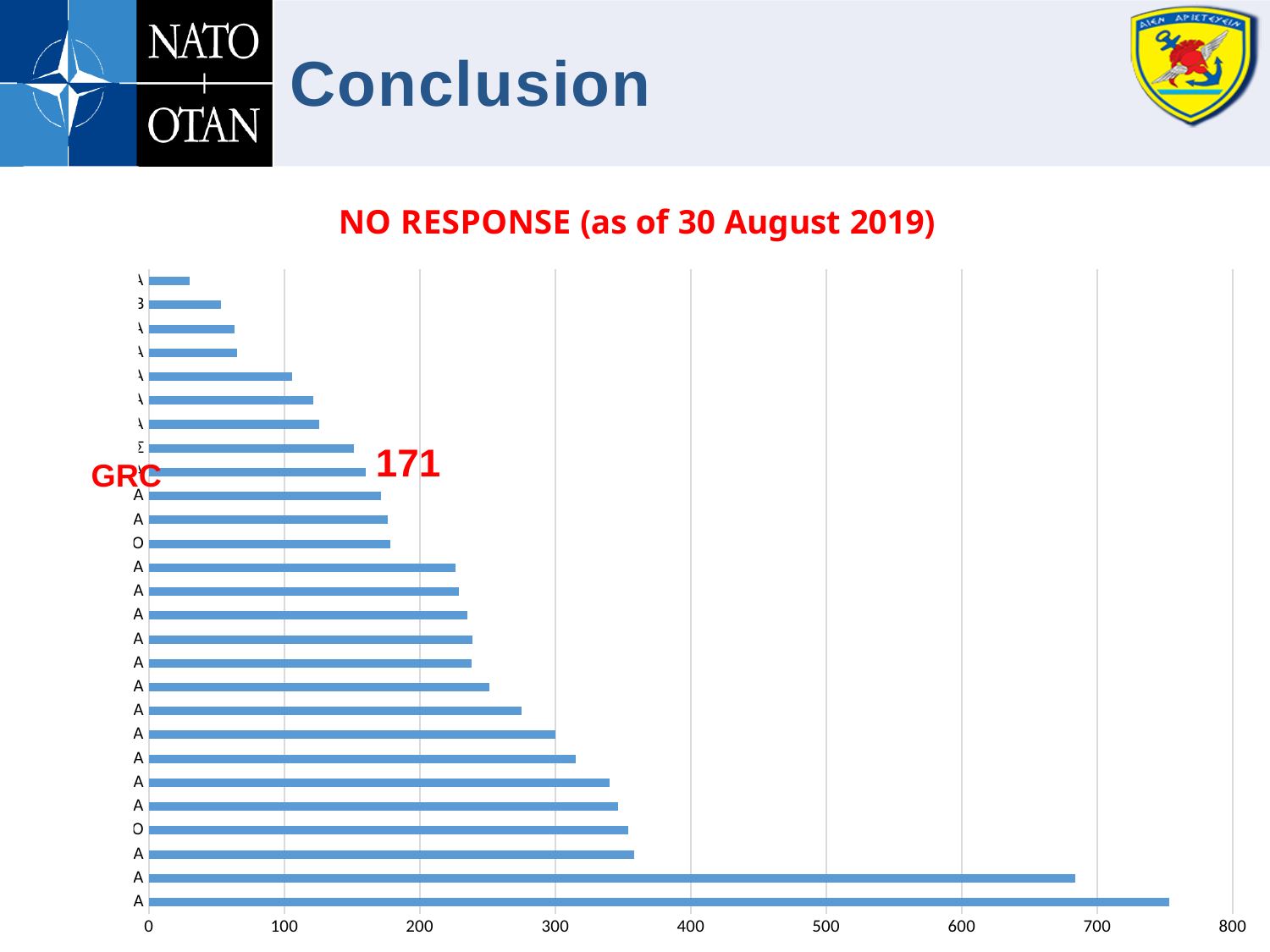
Is the value for GRC greater or less than 200? less What kind of chart is shown on the slide? bar chart Do the bar lengths increase or decrease from the top of the chart to the bottom? increase Is the bar at the bottom of the chart longer or shorter than the bar for GRC? longer What is the title of the chart? NO RESPONSE (as of 30 August 2019) Is the value for GRC greater or less than 100? greater Is the longest bar on the chart greater or less than 700? greater What value is annotated for GRC on the chart? 171 How many bars are plotted on the chart? 27 What is the maximum value shown on the horizontal axis? 800